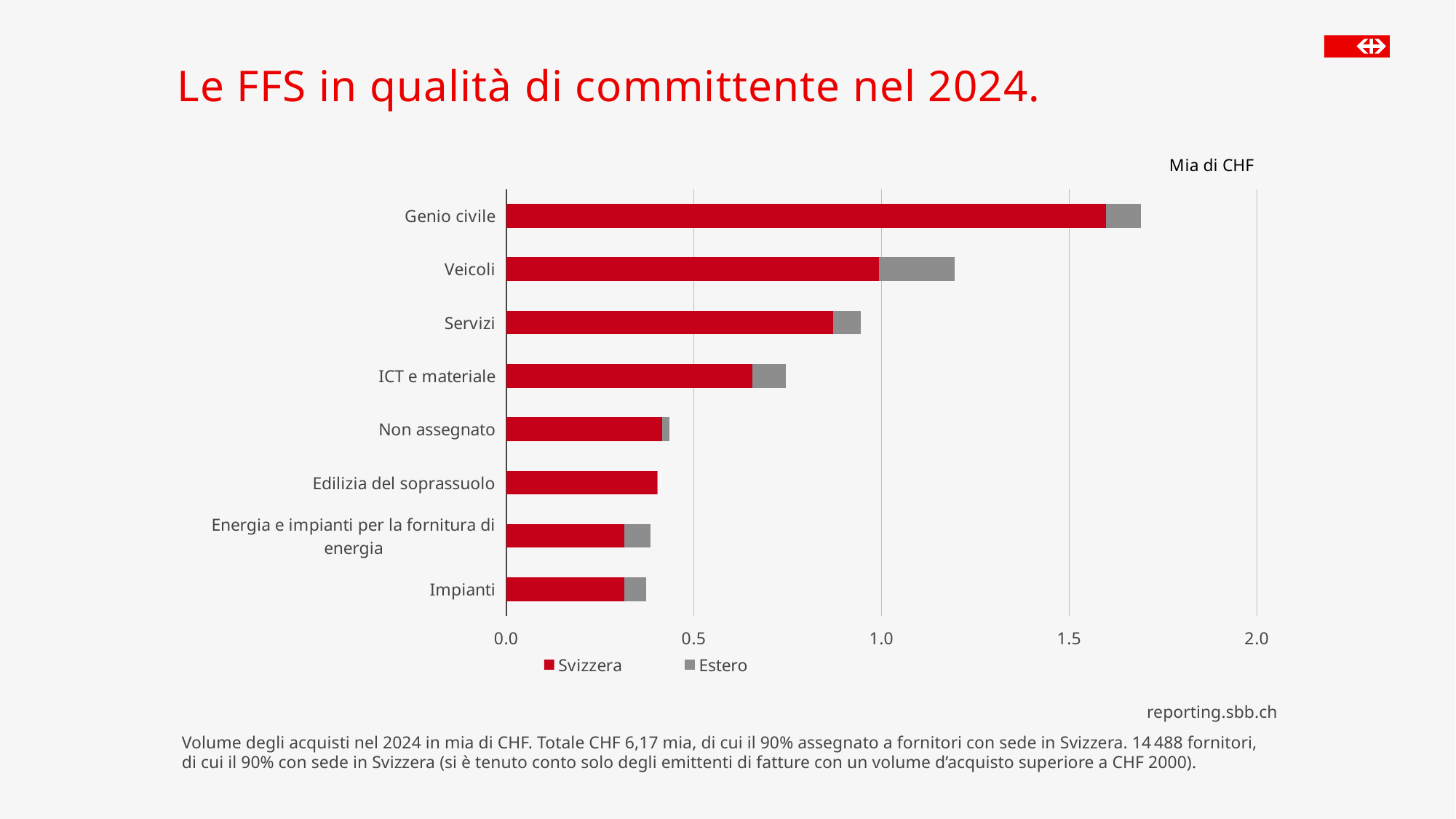
How many categories are plotted on the chart? 8 What are the two series named in the legend? Svizzera and Estero Is the total value for Veicoli greater or less than 1.0? greater How many series does the legend list? 2 Is the total value for Non assegnato greater or less than 0.5? less Is the total value for Genio civile greater or less than 1.5? greater What kind of chart is shown on the slide? Stacked horizontal bar chart What unit is indicated for the values on the chart? Mia di CHF Which has the larger total value, Veicoli or Servizi? Veicoli Which category has the highest total purchase volume? Genio civile